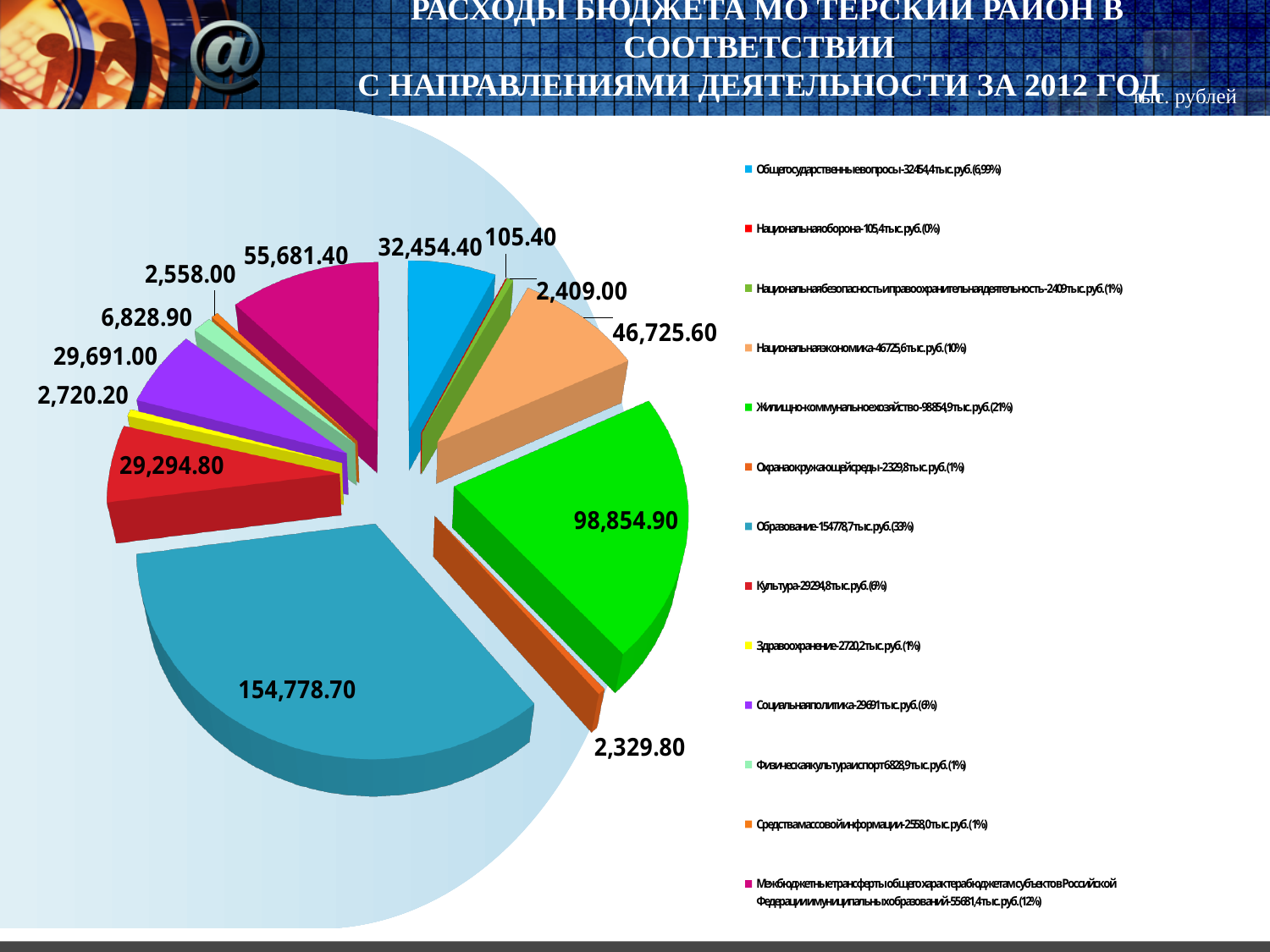
In what units are the values on the chart expressed, according to the slide? тыс. рублей What is the value shown for Образование? 154,778.70 What is the difference between the values for Образование and Жилищно-коммунальное хозяйство? 55,923.80 What kind of chart is shown on the slide? Pie chart Which is larger, the value for Культура or the value for Социальная политика? Социальная политика What is the value shown for Жилищно-коммунальное хозяйство? 98,854.90 How many slices does the pie chart have? 13 Which category has the smallest slice of the pie? Национальная оборона According to the legend, what share of the pie does Образование represent? 33% What is the value shown for Национальная экономика? 46,725.60 How many entries does the legend list? 13 Which category has the largest slice of the pie? Образование